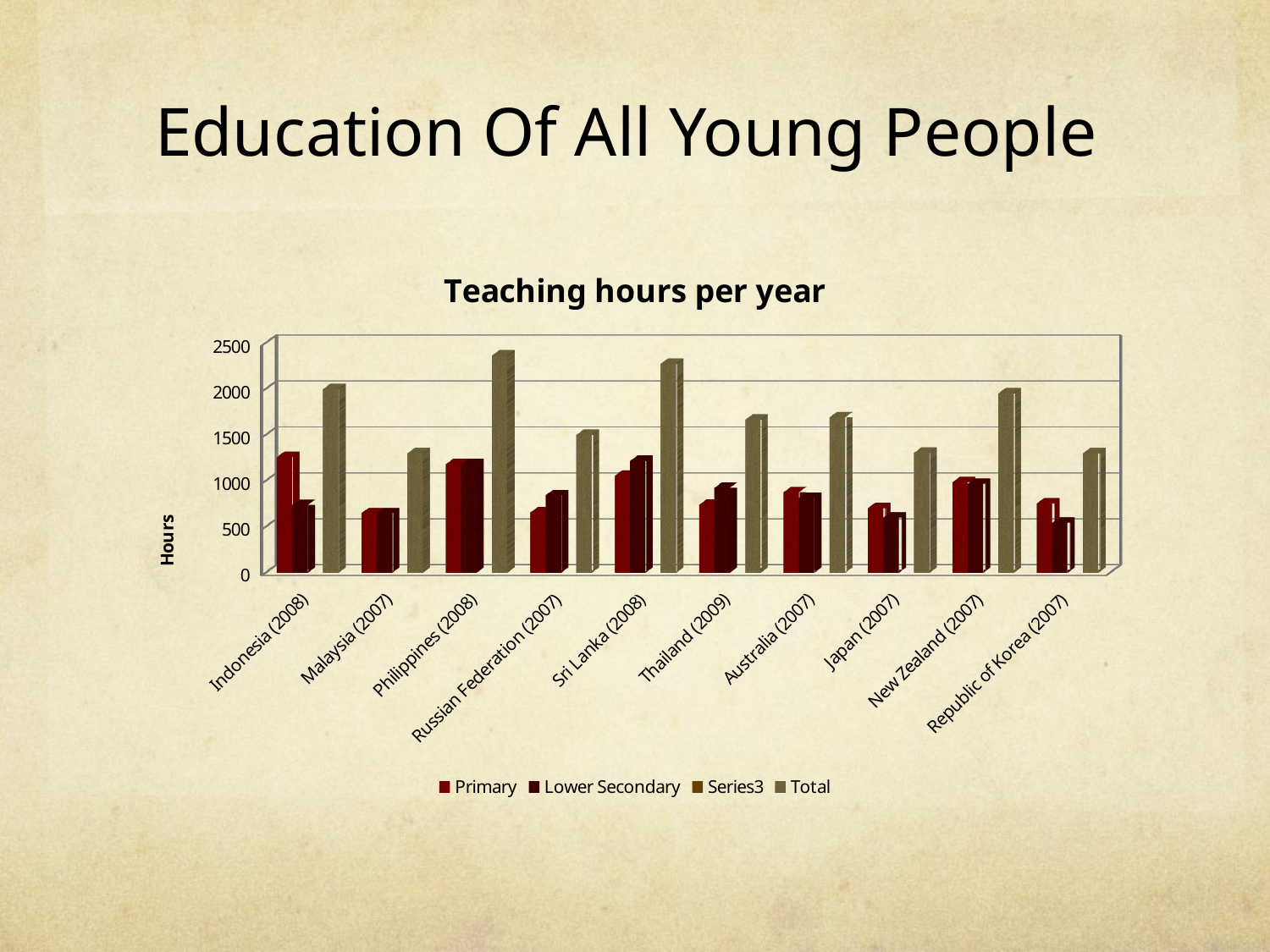
Which country has the highest Total teaching hours? Philippines (2008) For Indonesia (2008), which is larger: the Primary value or the Lower Secondary value? Primary How many countries (categories) are shown on the x axis of the chart? 10 Is the Total value for Philippines (2008) greater or less than 2000? greater Which is larger: the Total value for Sri Lanka (2008) or the Total value for Japan (2007)? Sri Lanka (2008) What is the label on the vertical axis of the chart? Hours Is the Primary value for Indonesia (2008) greater or less than 1000? greater Is the Lower Secondary value for Japan (2007) greater or less than 1000? less What is the title of the chart? Teaching hours per year What kind of chart is shown on the slide? bar chart How many series does the chart's legend list? 4